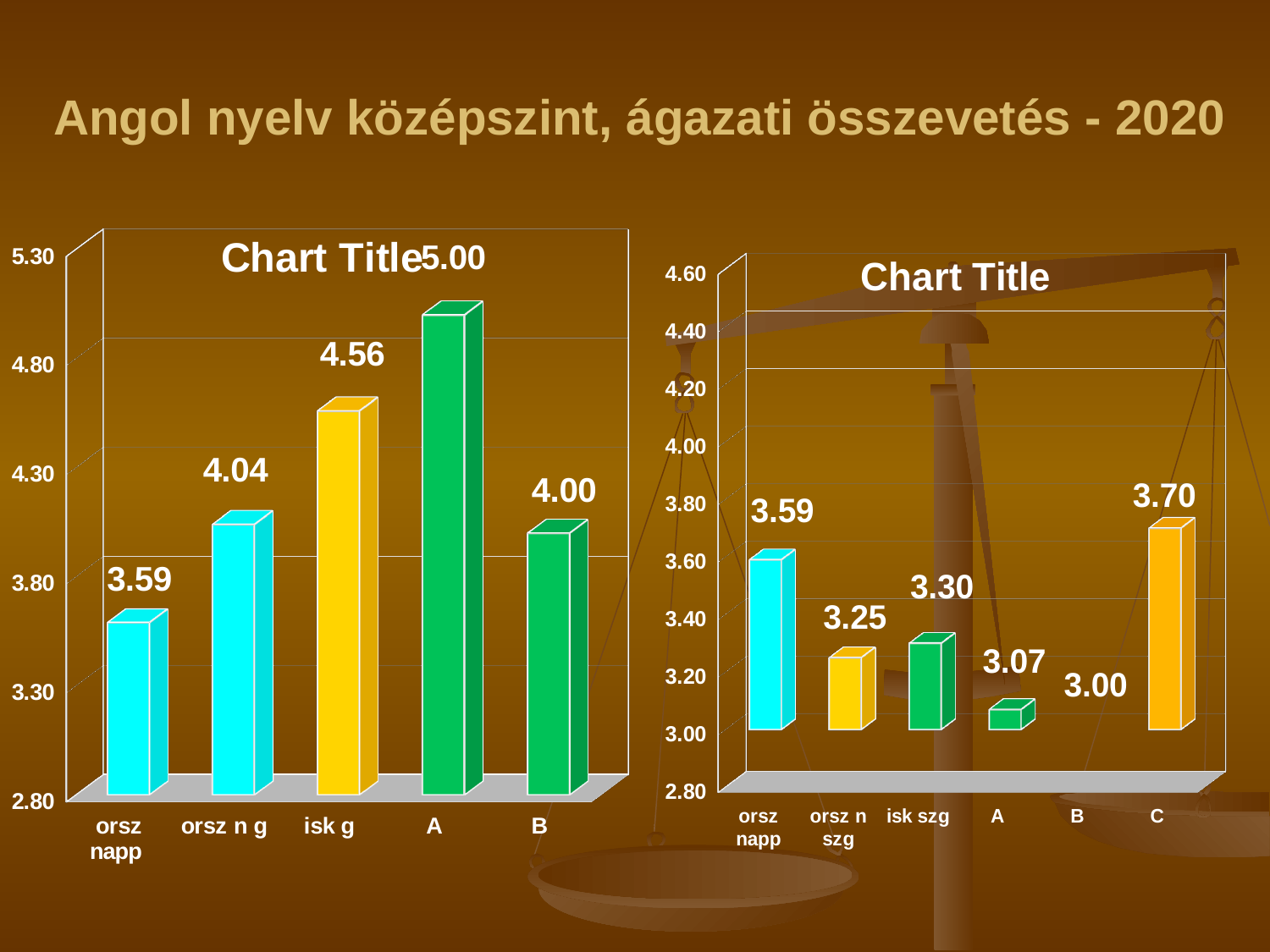
On the right chart, which is larger, the value for isk szg or the value for A? isk szg On the right chart, which category has the highest value? C On the right chart, what is the value for orsz n szg? 3.25 On the left chart, what is the value for isk g? 4.56 On the right chart, how many categories are shown? 6 On the left chart, which category has the highest value? A On the left chart, what is the difference between the values for A and B? 1.00 On the left chart, which category has the lowest value? orsz napp On the left chart, how many categories are shown? 5 On the right chart, what is the difference between the values for orsz napp and A? 0.52 What kind of chart is the left chart? bar chart On the right chart, which category has the lowest value? B